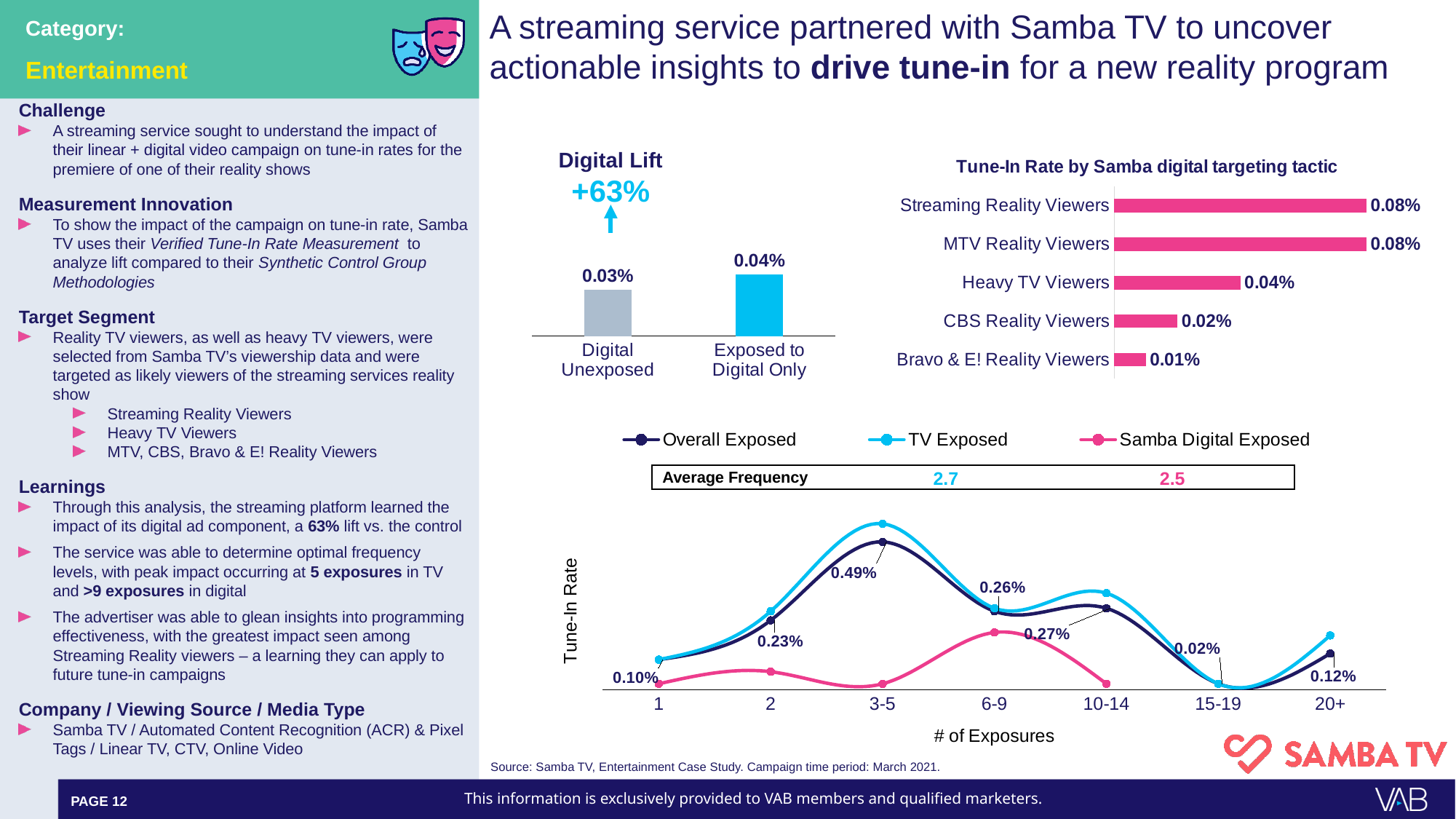
In the line chart at the bottom of the slide, what is the Overall Exposed tune-in rate at 3-5 exposures? 0.49% In the line chart at the bottom of the slide, how many series does the legend list? 3 In the Tune-In Rate by Samba digital targeting tactic chart, what is the difference between Heavy TV Viewers and CBS Reality Viewers? 0.02% In the Digital Lift chart, what is the difference between Exposed to Digital Only and Digital Unexposed? 0.01% In the Tune-In Rate by Samba digital targeting tactic chart, how many categories are shown? 5 In the Digital Lift chart, which of the two bars is higher, Digital Unexposed or Exposed to Digital Only? Exposed to Digital Only In the Tune-In Rate by Samba digital targeting tactic chart, which category has the lowest tune-in rate? Bravo & E! Reality Viewers In the Digital Lift chart, what is the tune-in rate for Digital Unexposed? 0.03% In the Tune-In Rate by Samba digital targeting tactic chart, what is the tune-in rate for Heavy TV Viewers? 0.04% In the Digital Lift chart, what is the tune-in rate for Exposed to Digital Only? 0.04% In the line chart at the bottom of the slide, how many exposure groups are shown on the x axis? 7 In the Tune-In Rate by Samba digital targeting tactic chart, what kind of chart is used? Bar chart